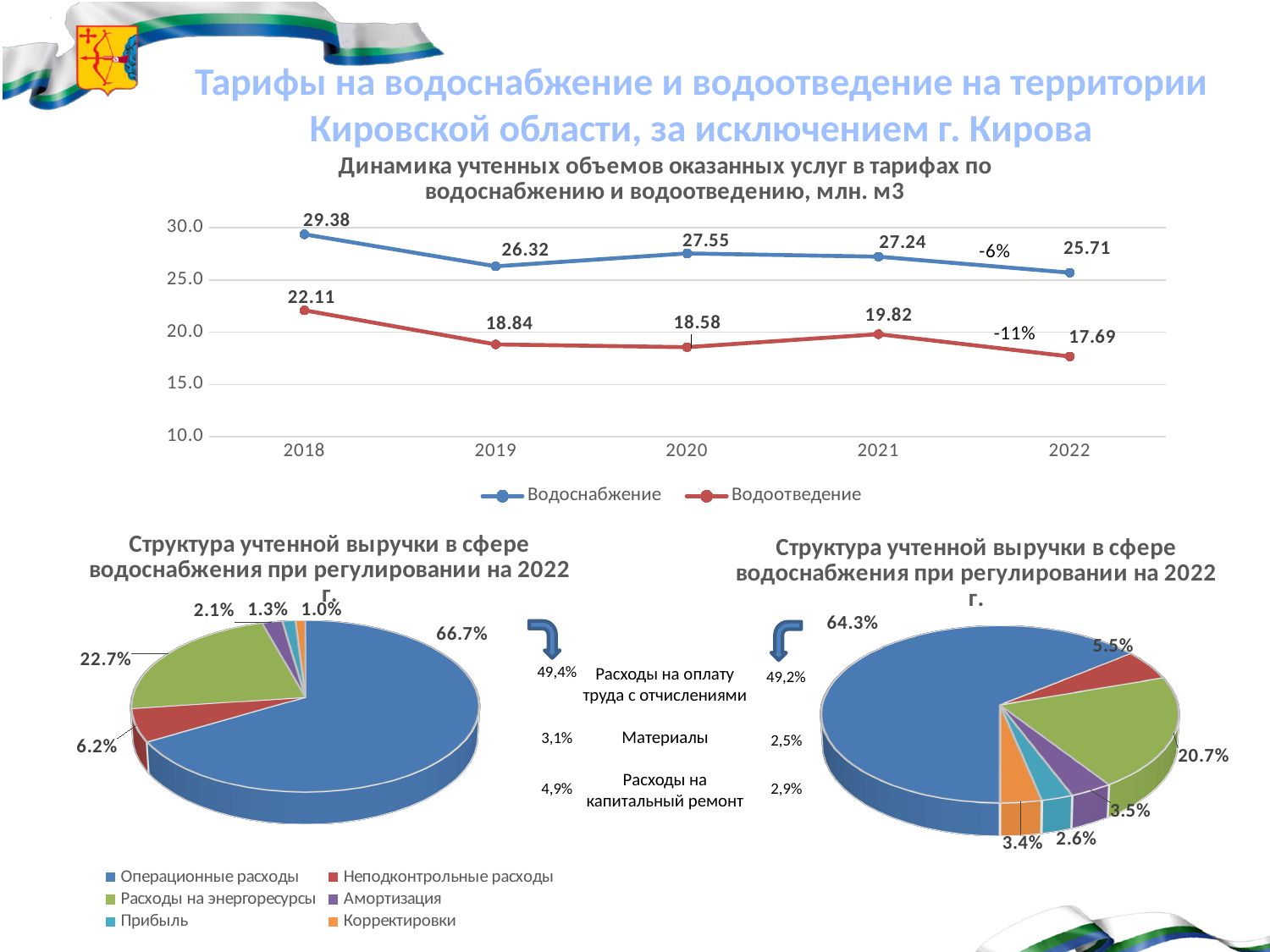
In the line chart at the top of the slide, what is the difference between Водоснабжение and Водоотведение in 2020? 8.97 In the line chart at the top of the slide, what is the value for Водоснабжение in 2018? 29.38 In the line chart at the top of the slide, in which year is the Водоотведение series lowest? 2022 In the pie chart on the bottom left of the slide, which category has the smallest share? Корректировки In the pie chart on the bottom left of the slide, what share does Операционные расходы have? 66.7% In the line chart at the top of the slide, which is larger in 2021: Водоснабжение or Водоотведение? Водоснабжение What kind of chart is the chart at the top of the slide? line chart In the pie chart on the bottom right of the slide, what share does Расходы на энергоресурсы have? 20.7% In the line chart at the top of the slide, in which year is the Водоснабжение series highest? 2018 In the line chart at the top of the slide, what is the value for Водоотведение in 2022? 17.69 How many years are shown on the x axis of the line chart at the top of the slide? 5 How many series does the legend of the line chart at the top of the slide list? 2